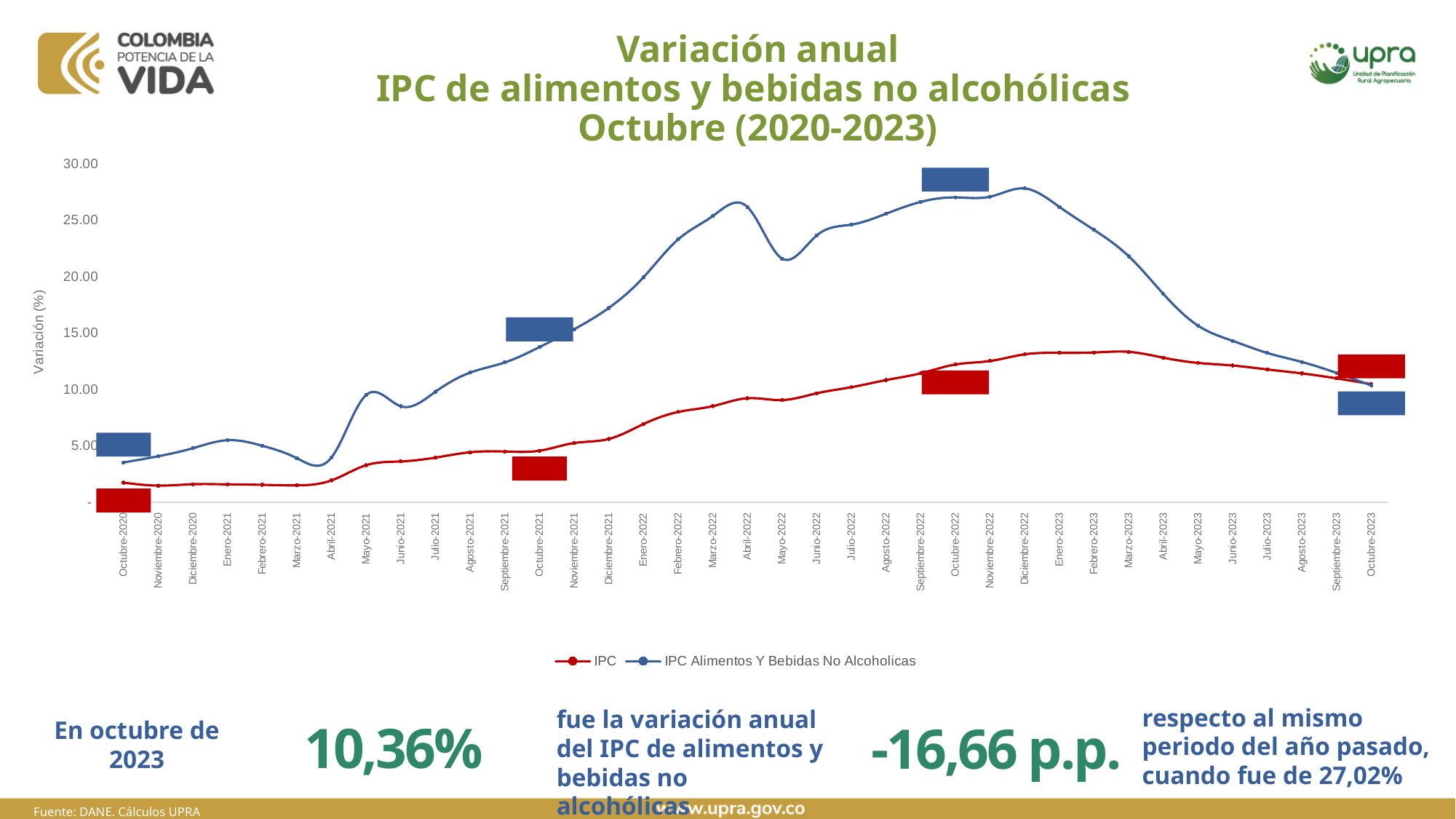
By how many percentage points did the annual variation of the IPC de alimentos y bebidas no alcohólicas change between October 2022 and October 2023, as stated on the slide? -16,66 p.p. According to the slide text, what was the annual variation of the IPC de alimentos y bebidas no alcohólicas in October 2023? 10,36% Is the value of the IPC Alimentos Y Bebidas No Alcoholicas line for Abril-2022 greater or less than 25.00? greater In Abril-2022, which series has the higher value: IPC or IPC Alimentos Y Bebidas No Alcoholicas? IPC Alimentos Y Bebidas No Alcoholicas Is the value of the IPC line for Marzo-2023 greater or less than 15.00? less In which month does the IPC Alimentos Y Bebidas No Alcoholicas line reach its highest value? Diciembre-2022 How many series does the legend list? 2 Is the value of the IPC Alimentos Y Bebidas No Alcoholicas line for Octubre-2020 greater or less than 5.00? less According to the slide text, what was the annual variation of the IPC de alimentos y bebidas no alcohólicas in October 2022? 27,02% What kind of chart is shown on the slide? Line chart How many monthly points are plotted along the x axis, from Octubre-2020 to Octubre-2023? 37 Does the IPC Alimentos Y Bebidas No Alcoholicas line rise or fall from Diciembre-2022 to Octubre-2023? Fall